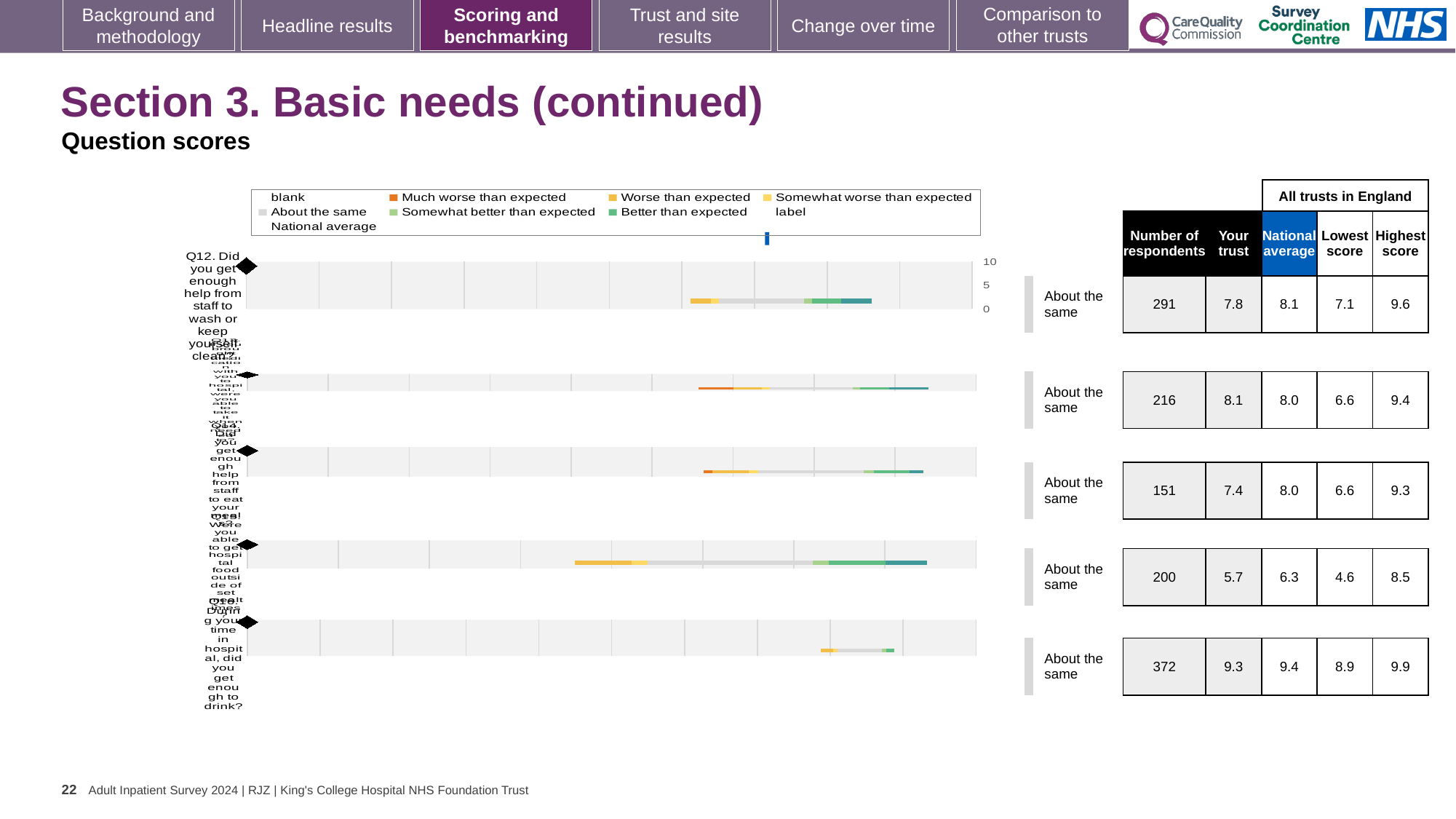
What type of chart is used to show the question scores on this slide? bar chart In the table, what is the number of respondents for the first row (Q12, help from staff to wash or keep yourself clean)? 291 Which row in the table has the lowest 'Your trust' score? the fourth row (Q15), 5.7 In the fourth row (Q15), which is larger: the 'Your trust' score or the national average? the national average (6.3) In the table, what is the national average for the last row (Q16, did you get enough to drink)? 9.4 What benchmark category is shown next to every question in the chart? About the same Which row in the table has the highest number of respondents? the last row (Q16), 372 How many questions (bars) are plotted in the chart? 5 According to the legend, what does the blue marker represent? National average What is the difference between the highest score and the lowest score in the first row (Q12)? 2.5 In the table, what is the 'Your trust' score for the first row (Q12)? 7.8 In the table, what is the lowest score for the fourth row (Q15, hospital food outside of set meal times)? 4.6